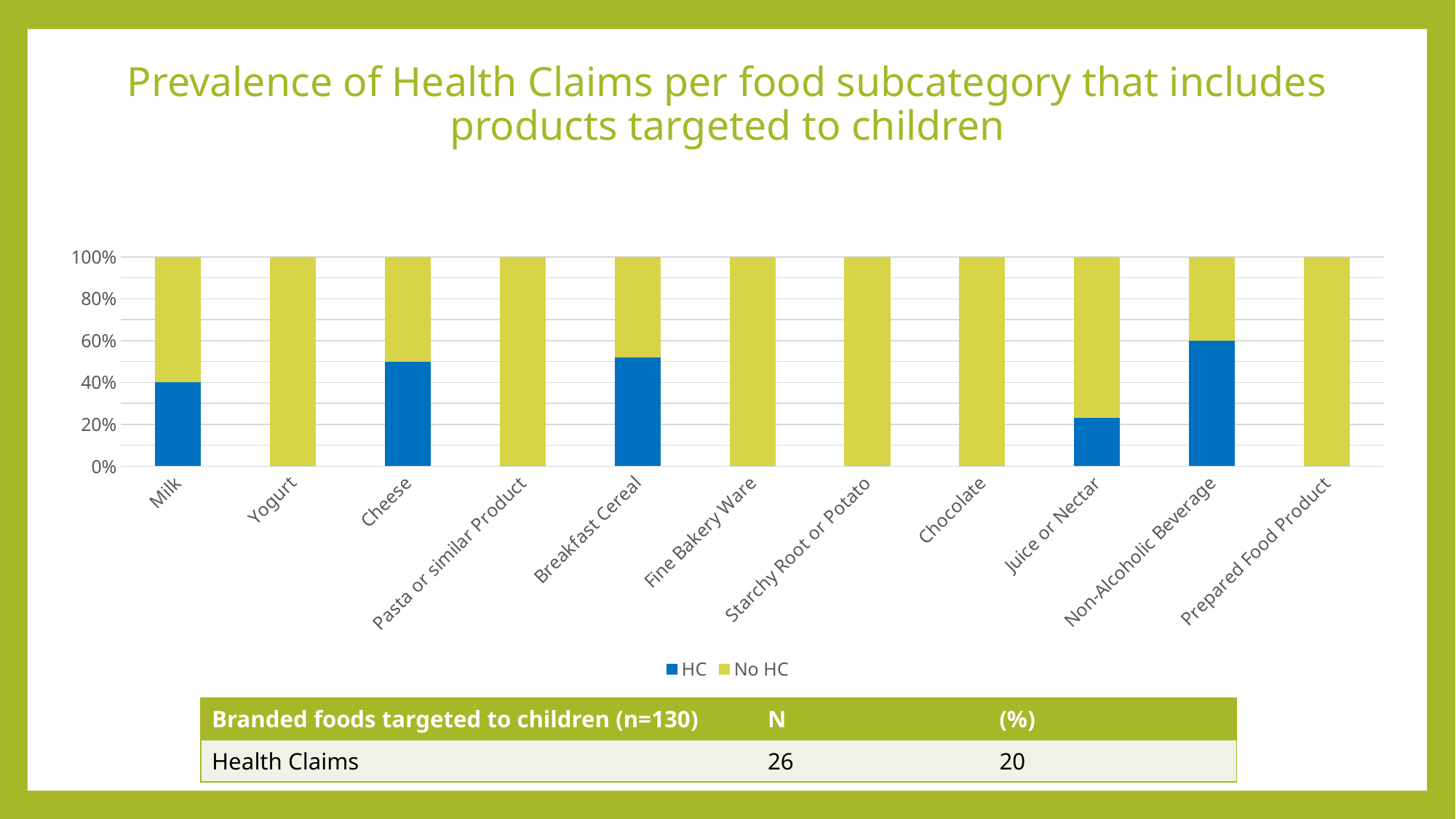
What is the HC share for Non-Alcoholic Beverage? 60% What kind of chart is shown on the slide? Stacked bar chart How many food subcategories are shown on the x axis? 11 Is the HC share for Breakfast Cereal greater or less than 40%? greater Which colour represents the HC series in the legend? Blue Which has a larger HC share, Milk or Juice or Nectar? Milk Which food subcategory has the highest HC share? Non-Alcoholic Beverage Does the Yogurt bar show any HC share? No Is the HC share for Juice or Nectar greater or less than 40%? less How many series does the legend list? 2 What is the HC share for Milk? 40% What is the total height of each stacked bar? 100%